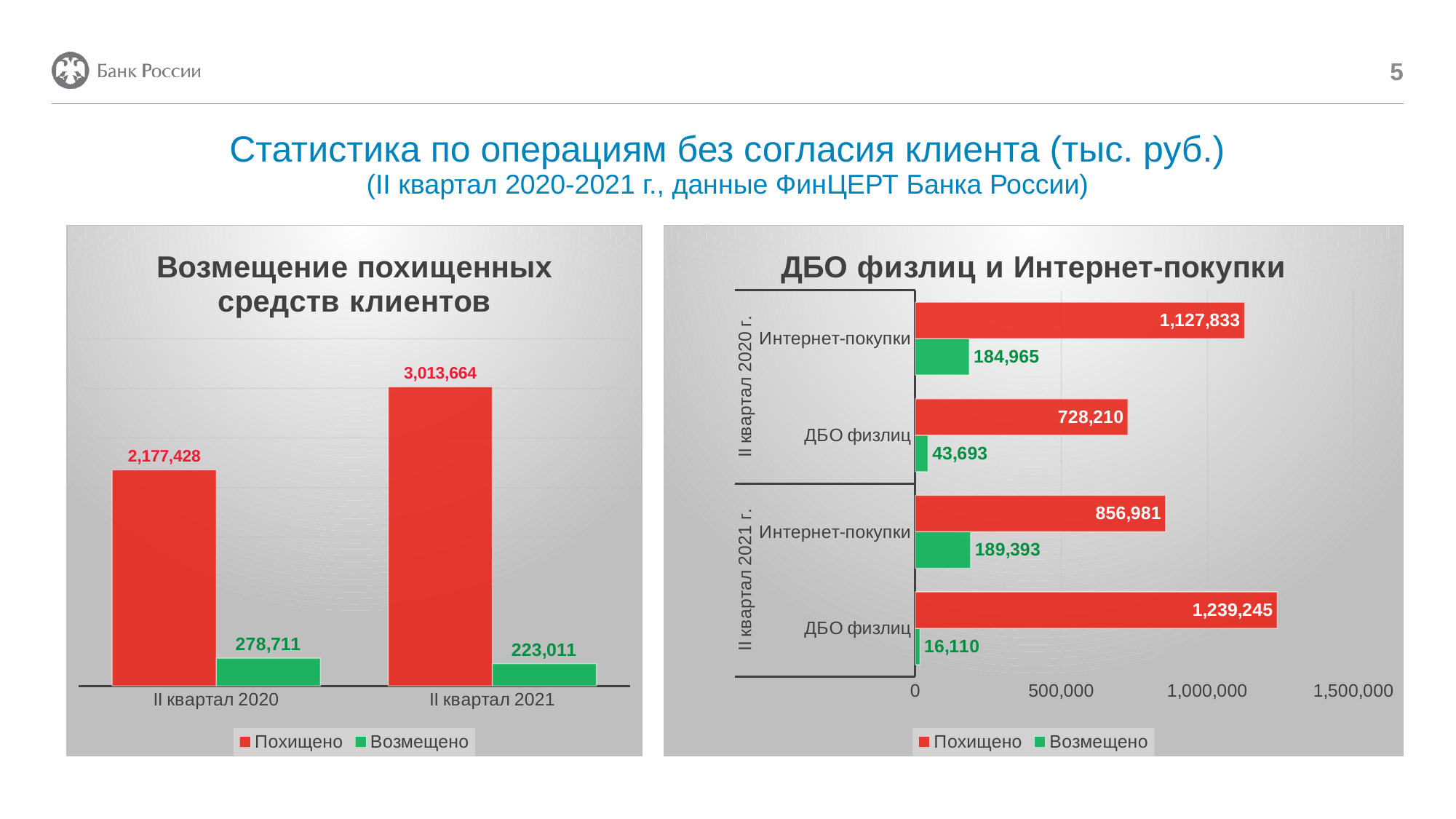
In the chart 'ДБО физлиц и Интернет-покупки', which bar has the lowest value? Возмещено for ДБО физлиц, II квартал 2021 г. (16,110) In the chart 'Возмещение похищенных средств клиентов', does Возмещено rise or fall from II квартал 2020 to II квартал 2021? fall In the chart 'Возмещение похищенных средств клиентов', what is the difference between Возмещено in II квартал 2020 and II квартал 2021? 55,700 In the chart 'Возмещение похищенных средств клиентов', what is the value of Возмещено for II квартал 2020? 278,711 In the chart 'Возмещение похищенных средств клиентов', how many series does the legend list? 2 In the chart 'ДБО физлиц и Интернет-покупки', what is the Похищено value for ДБО физлиц in II квартал 2021 г.? 1,239,245 In the chart 'Возмещение похищенных средств клиентов', by how much did Похищено increase from II квартал 2020 to II квартал 2021? 836,236 In the chart 'ДБО физлиц и Интернет-покупки', what is the Возмещено value for Интернет-покупки in II квартал 2020 г.? 184,965 In the chart 'ДБО физлиц и Интернет-покупки', how much higher is Похищено for ДБО физлиц in II квартал 2021 г. than in II квартал 2020 г.? 511,035 In the chart 'Возмещение похищенных средств клиентов', what is the value of Похищено for II квартал 2021? 3,013,664 What type of chart is 'ДБО физлиц и Интернет-покупки'? bar chart In the chart 'ДБО физлиц и Интернет-покупки', which is larger: Похищено for Интернет-покупки in II квартал 2020 г. or in II квартал 2021 г.? II квартал 2020 г.